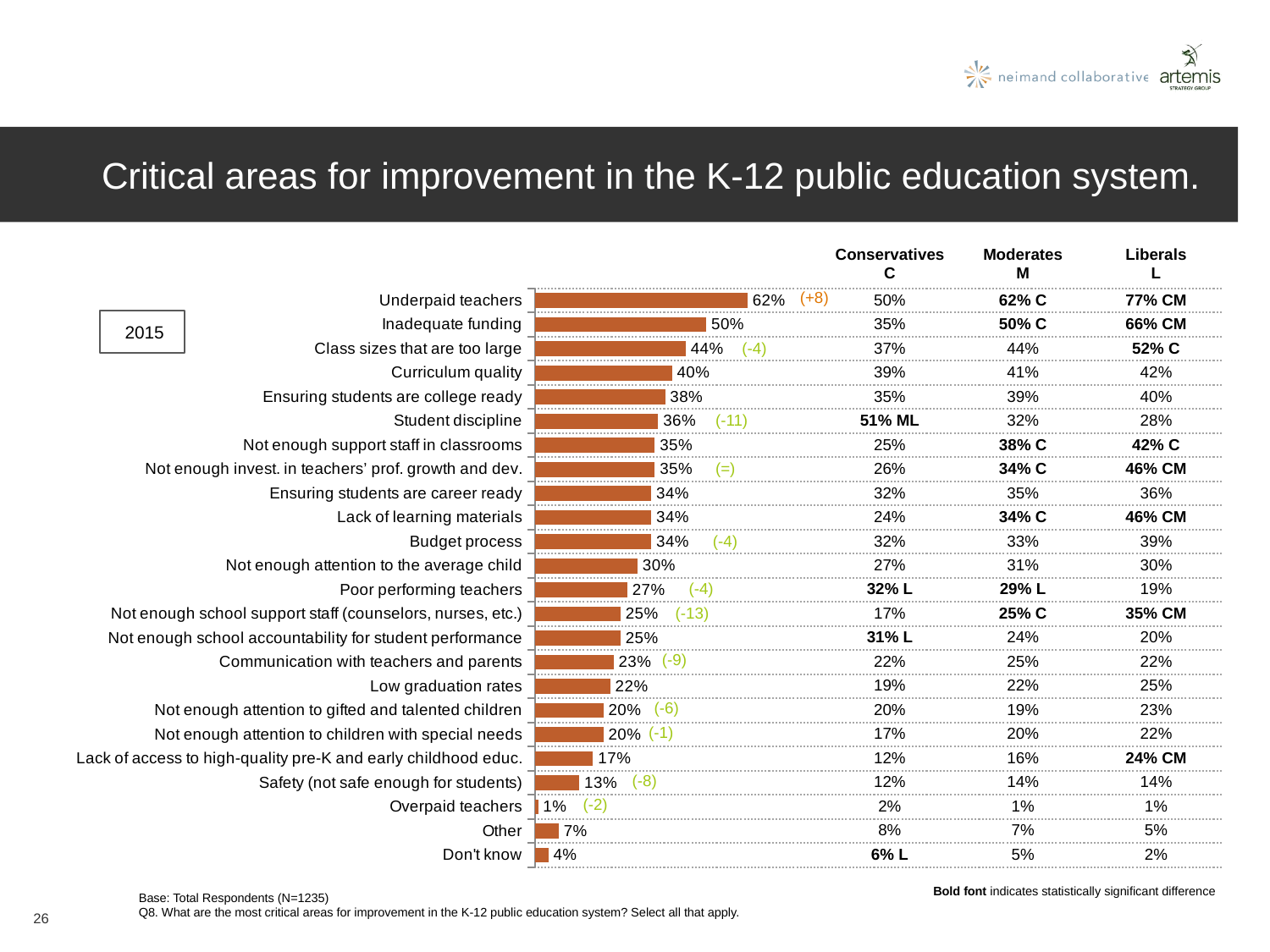
Which category has the highest value in the bar chart? Underpaid teachers What is the value for "Safety (not safe enough for students)"? 13% What is the difference between the values for "Underpaid teachers" and "Inadequate funding"? 12 percentage points What year is indicated in the box next to the chart? 2015 Which category has the lowest value in the bar chart? Overpaid teachers What percentage of respondents selected "Underpaid teachers" as a critical area for improvement? 62% Which has a larger value, "Other" or "Don't know"? Other What type of chart is shown on the slide? Bar chart How many categories are plotted in the bar chart? 24 What percentage is shown for "Student discipline"? 36% What is the value shown for "Inadequate funding"? 50% Which has a larger value, "Curriculum quality" or "Low graduation rates"? Curriculum quality